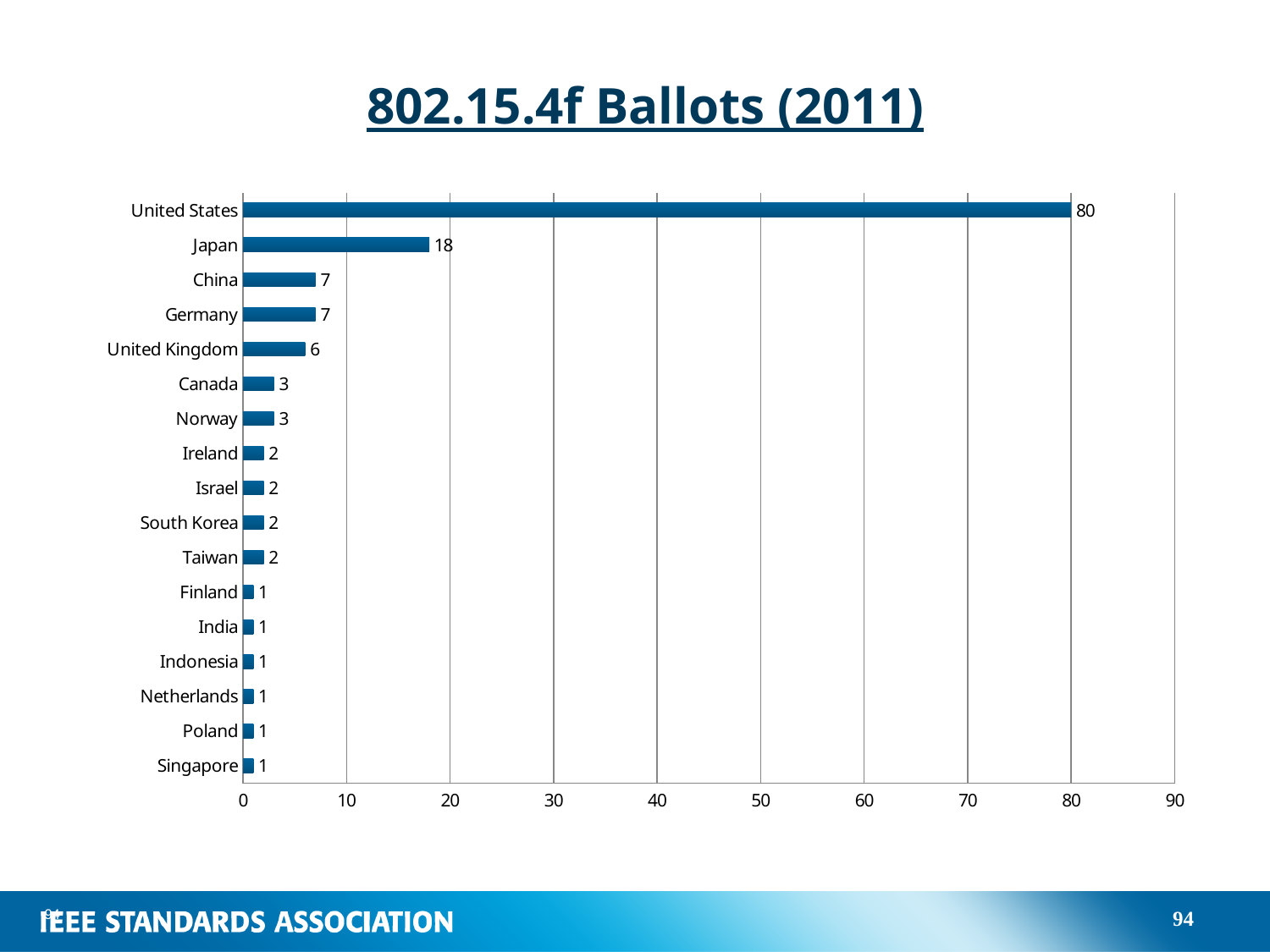
What is the value for United States? 80 What is the difference between the values for United States and Japan? 62 Which country has the highest number of ballots? United States How many countries are shown in the chart? 17 What is the value for Norway? 3 What is the title of the chart? 802.15.4f Ballots (2011) What is the difference between the values for Japan and China? 11 What kind of chart is shown on the slide? bar chart Which is larger, the value for Canada or the value for Ireland? Canada What is the value for United Kingdom? 6 Is the value for Japan greater or less than 20? less What is the value for Japan? 18